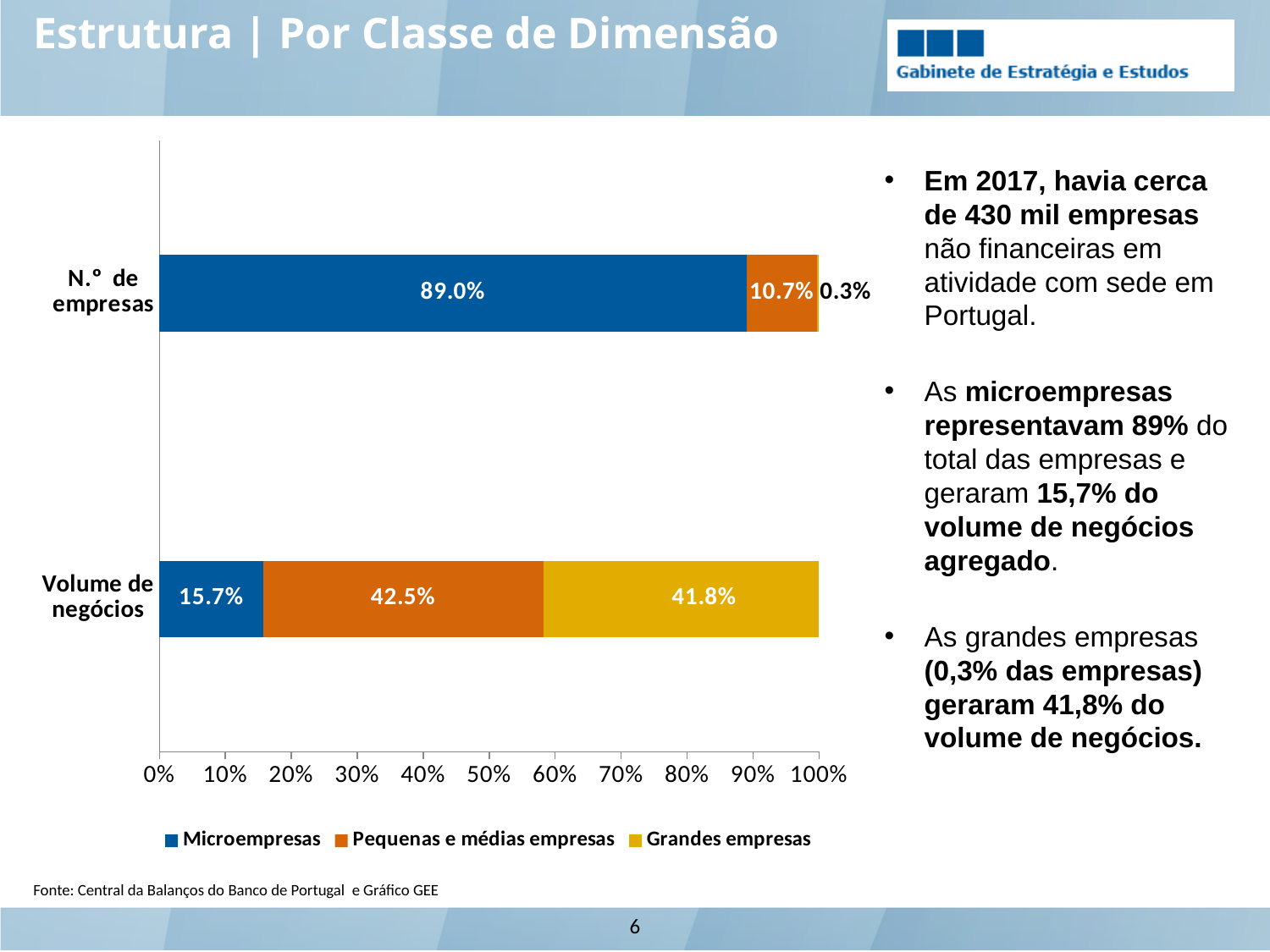
What is the value for Grandes empresas in the N.º de empresas bar? 0.3% How many series does the legend list? 3 Which series has the largest share in the N.º de empresas bar? Microempresas How many categories (bars) are shown in the chart? 2 What colour represents Grandes empresas in the chart? Yellow What is the value for Microempresas in the N.º de empresas bar? 89.0% What kind of chart is shown on the slide? Stacked horizontal bar chart What is the difference between the Microempresas values for N.º de empresas and Volume de negócios? 73.3 percentage points What is the value for Microempresas in the Volume de negócios bar? 15.7% Which series has the smallest share in the Volume de negócios bar? Microempresas In the Volume de negócios bar, which is larger: Pequenas e médias empresas or Grandes empresas? Pequenas e médias empresas What is the value for Pequenas e médias empresas in the Volume de negócios bar? 42.5%